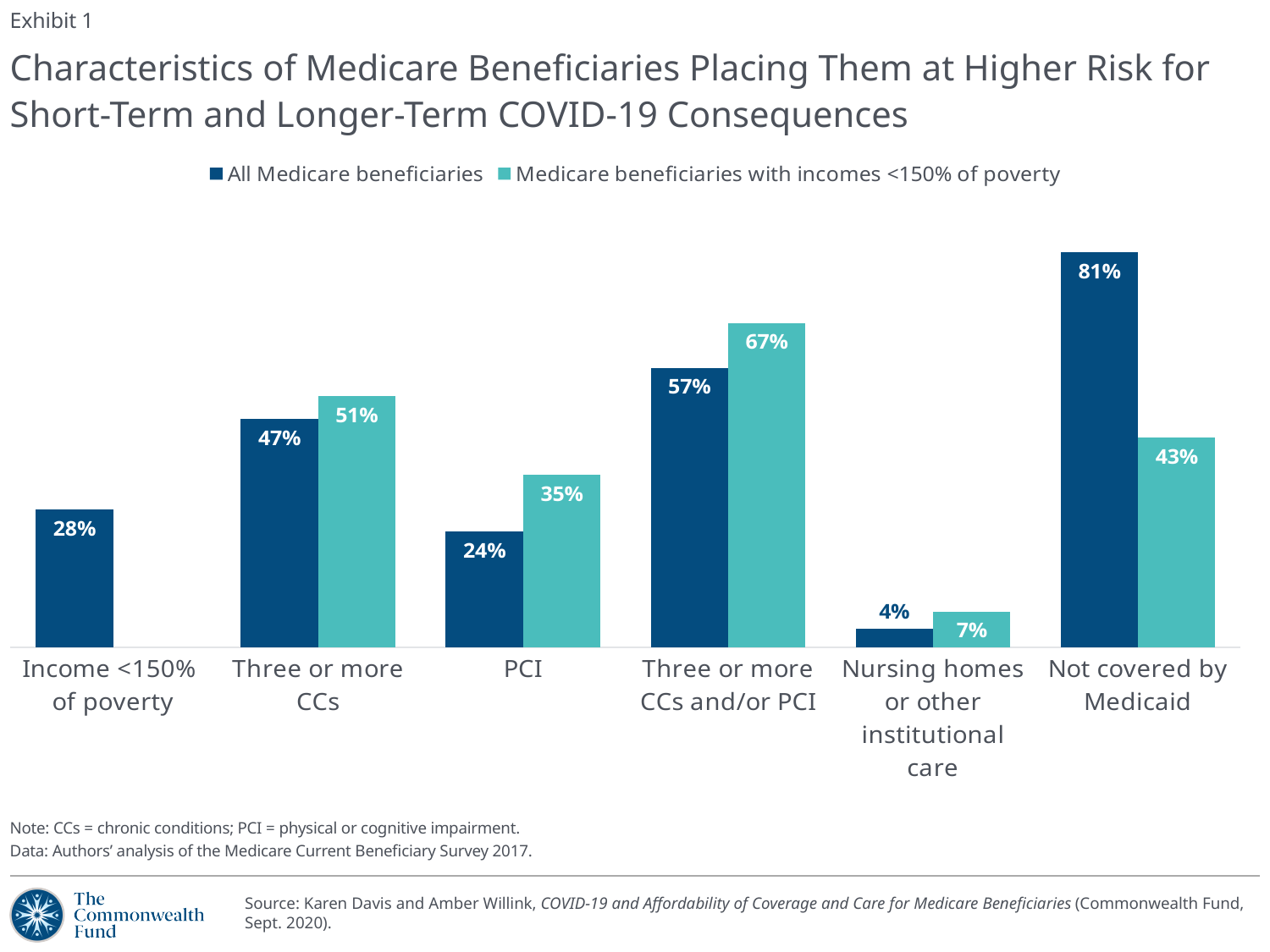
Which category has the lowest value for Medicare beneficiaries with incomes <150% of poverty? Nursing homes or other institutional care What kind of chart is shown on the slide? Bar chart What is the value for Medicare beneficiaries with incomes <150% of poverty in the PCI category? 35% In the 'Not covered by Medicaid' category, which series has the larger value? All Medicare beneficiaries What is the difference between all Medicare beneficiaries and those with incomes <150% of poverty in the 'Not covered by Medicaid' category? 38 percentage points How many series does the legend list? 2 What percentage of all Medicare beneficiaries have three or more CCs? 47% What percentage of all Medicare beneficiaries are not covered by Medicaid? 81% How many categories are shown on the x axis? 6 Which category has the highest value for all Medicare beneficiaries? Not covered by Medicaid Which series is shown in dark blue in the legend? All Medicare beneficiaries What is the difference between the two series in the 'Three or more CCs and/or PCI' category? 10 percentage points